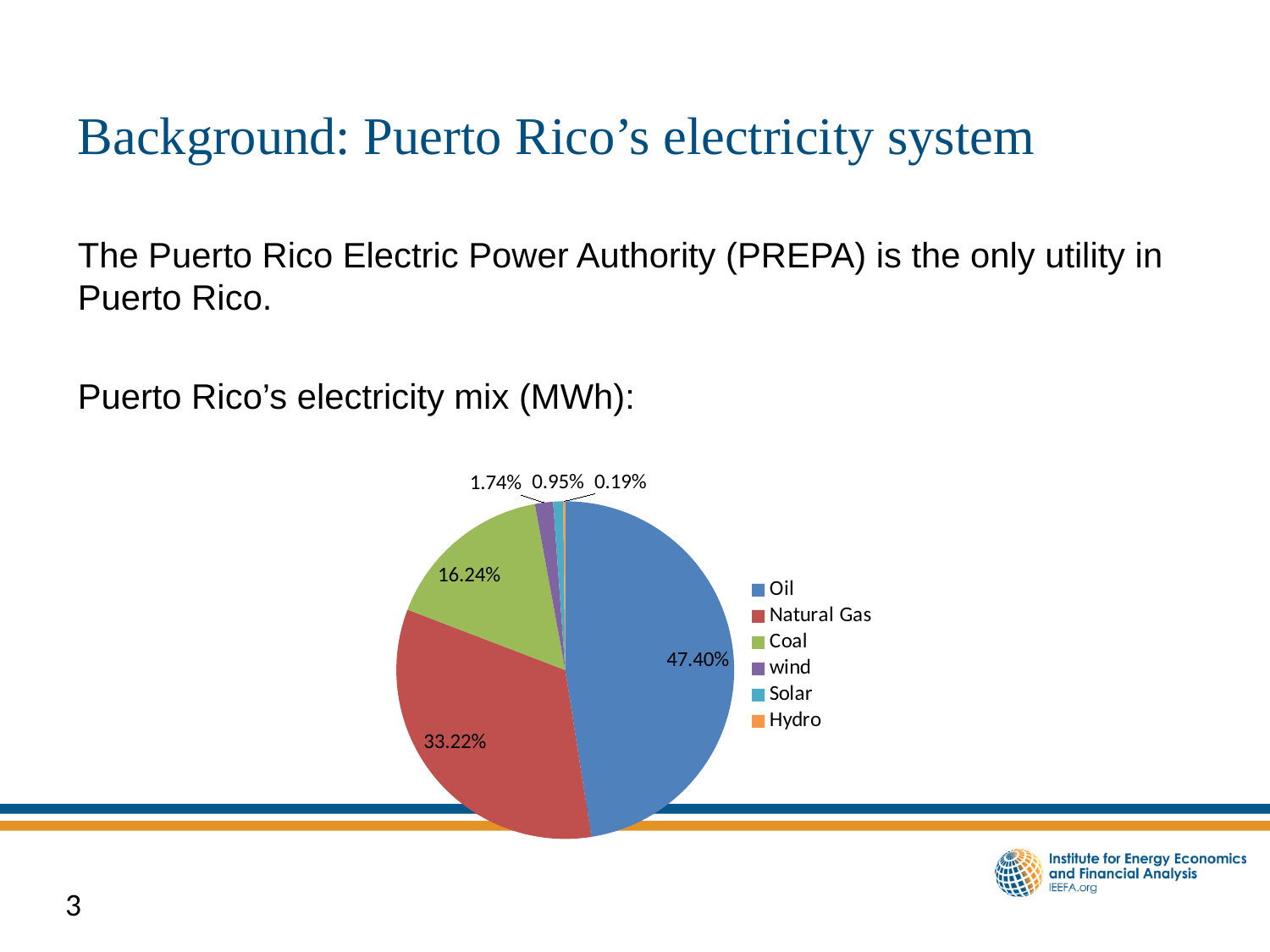
What is the combined share of Oil and Natural Gas in the electricity mix? 80.62% What share of Puerto Rico's electricity mix comes from Natural Gas? 33.22% What share of Puerto Rico's electricity mix comes from Coal? 16.24% Which source has the largest share of Puerto Rico's electricity mix? Oil What share of Puerto Rico's electricity mix comes from wind? 1.74% How many sources are listed in the legend of the pie chart? 6 What colour represents Coal in the pie chart? green Which has a larger share of the electricity mix, Natural Gas or Coal? Natural Gas What share of Puerto Rico's electricity mix comes from Oil? 47.40% Which source has the smallest share of Puerto Rico's electricity mix? Hydro What is the difference in percentage points between the Oil share and the Natural Gas share? 14.18 What kind of chart is shown on the slide? pie chart